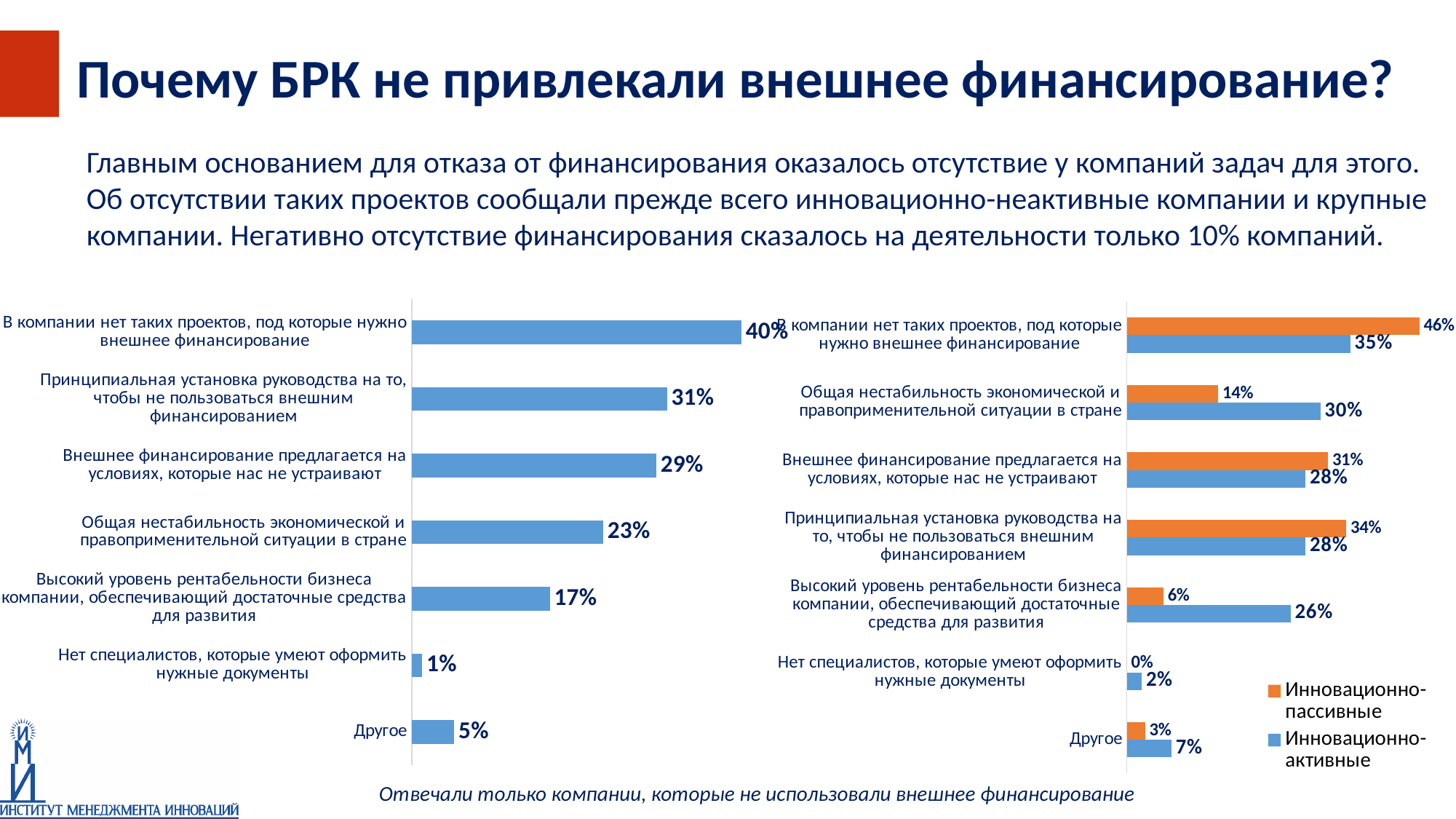
How many series does the legend of the right chart list? 2 In the left chart, what is the difference between «Внешнее финансирование предлагается на условиях, которые нас не устраивают» and «Общая нестабильность экономической и правоприменительной ситуации в стране»? 6% What type of chart is the left chart? bar chart In the right chart, which colour represents «Инновационно-пассивные»? orange In the right chart, what is the difference between «Инновационно-пассивные» and «Инновационно-активные» for «Принципиальная установка руководства на то, чтобы не пользоваться внешним финансированием»? 6% In the right chart, which is larger for «Общая нестабильность экономической и правоприменительной ситуации в стране»: «Инновационно-пассивные» or «Инновационно-активные»? Инновационно-активные How many categories does the left chart show? 7 In the right chart, what is the value for «Инновационно-пассивные» in «В компании нет таких проектов, под которые нужно внешнее финансирование»? 46% In the left chart, which category has the highest value? В компании нет таких проектов, под которые нужно внешнее финансирование In the left chart, what is the value for «Принципиальная установка руководства на то, чтобы не пользоваться внешним финансированием»? 31% In the right chart, what is the value for «Инновационно-активные» in «Высокий уровень рентабельности бизнеса компании, обеспечивающий достаточные средства для развития»? 26% In the left chart, which category has the lowest value? Нет специалистов, которые умеют оформить нужные документы